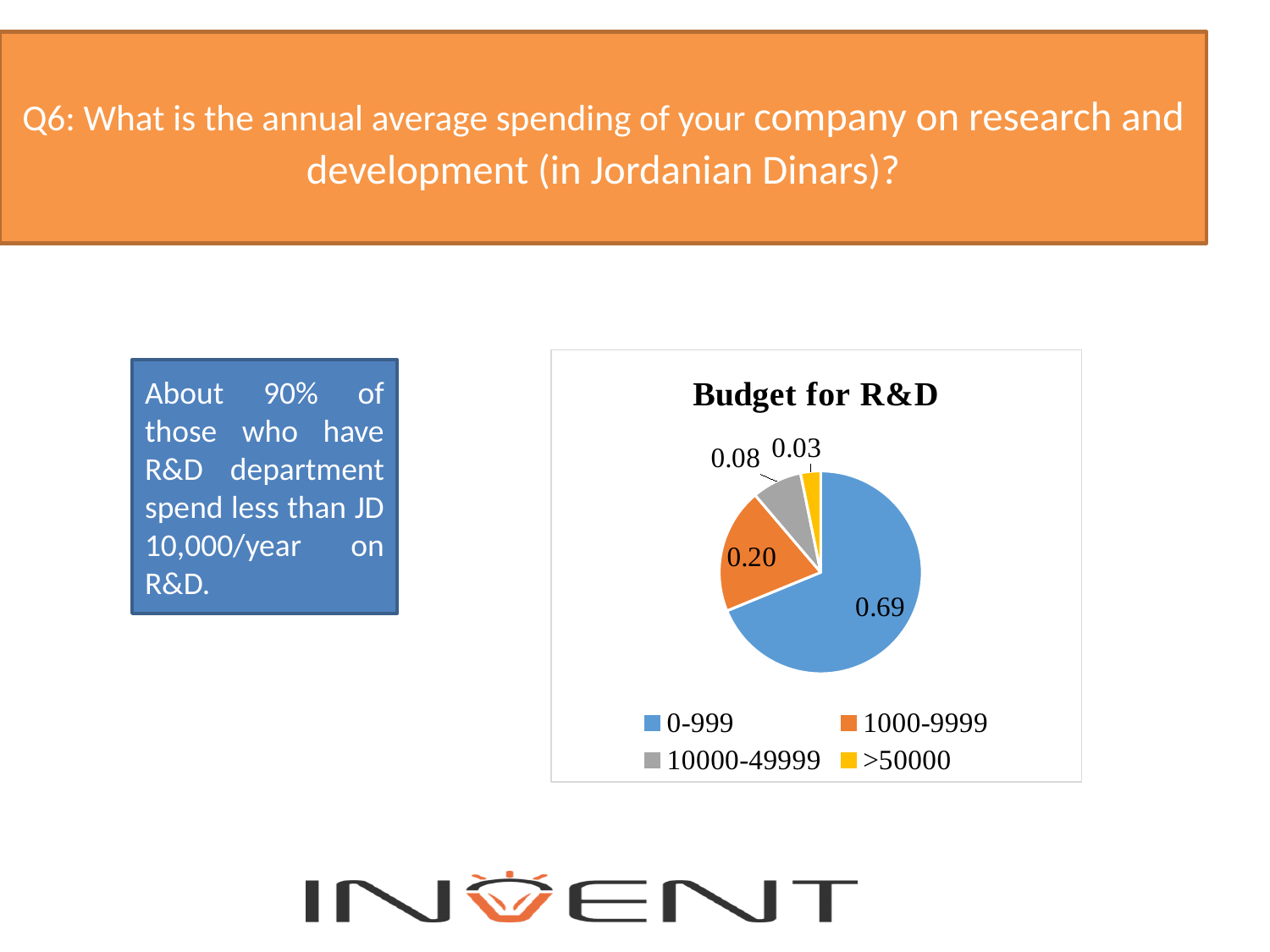
What kind of chart is used to show the Budget for R&D? Pie chart Which category has the smallest slice in the Budget for R&D pie chart? >50000 What colour is the 1000-9999 slice in the Budget for R&D pie chart? Orange Which is larger in the Budget for R&D pie chart, the 10000-49999 slice or the >50000 slice? 10000-49999 What is the value for the 10000-49999 slice in the Budget for R&D pie chart? 0.08 What is the value for the 0-999 slice in the Budget for R&D pie chart? 0.69 What is the difference between the 0-999 and 1000-9999 values in the Budget for R&D pie chart? 0.49 Which category has the largest slice in the Budget for R&D pie chart? 0-999 What is the value for the >50000 slice in the Budget for R&D pie chart? 0.03 How many categories does the Budget for R&D pie chart show? 4 What is the value for the 1000-9999 slice in the Budget for R&D pie chart? 0.20 What is the title of the chart on the slide? Budget for R&D